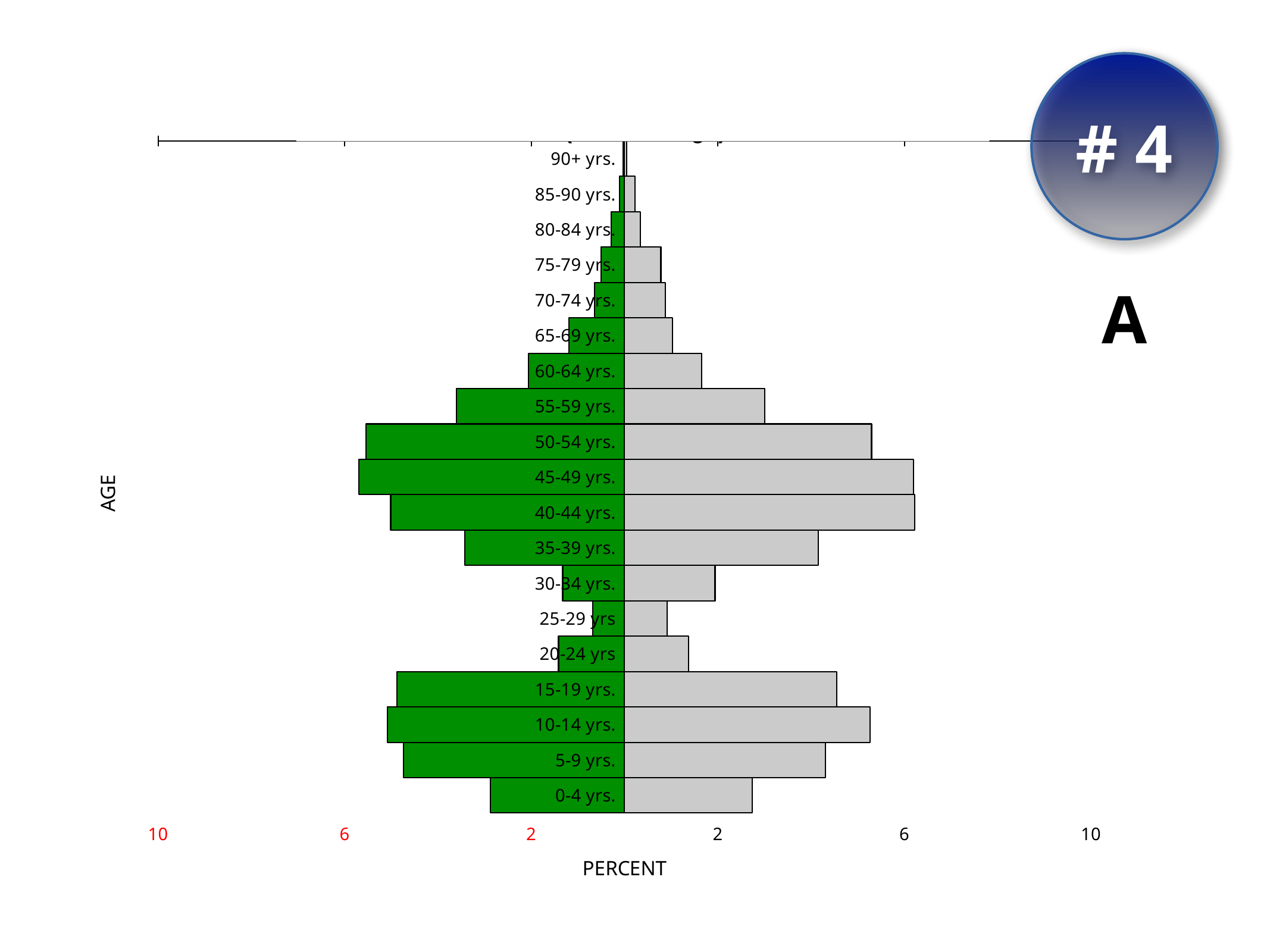
Is the grey bar value for 10-14 yrs. greater or less than 2? greater Is the grey bar value for 25-29 yrs greater or less than 2? less What is the label of the horizontal axis? PERCENT Which age group has the smallest bars on both sides of the chart? 90+ yrs. Is the green bar value for 20-24 yrs greater or less than 2? less Which grey bar is longer, 10-14 yrs. or 0-4 yrs.? 10-14 yrs. How many age groups are listed on the chart? 19 What is the label of the vertical axis? AGE What kind of chart is shown on the slide? bar chart Which green bar is longer, 35-39 yrs. or 25-29 yrs? 35-39 yrs.